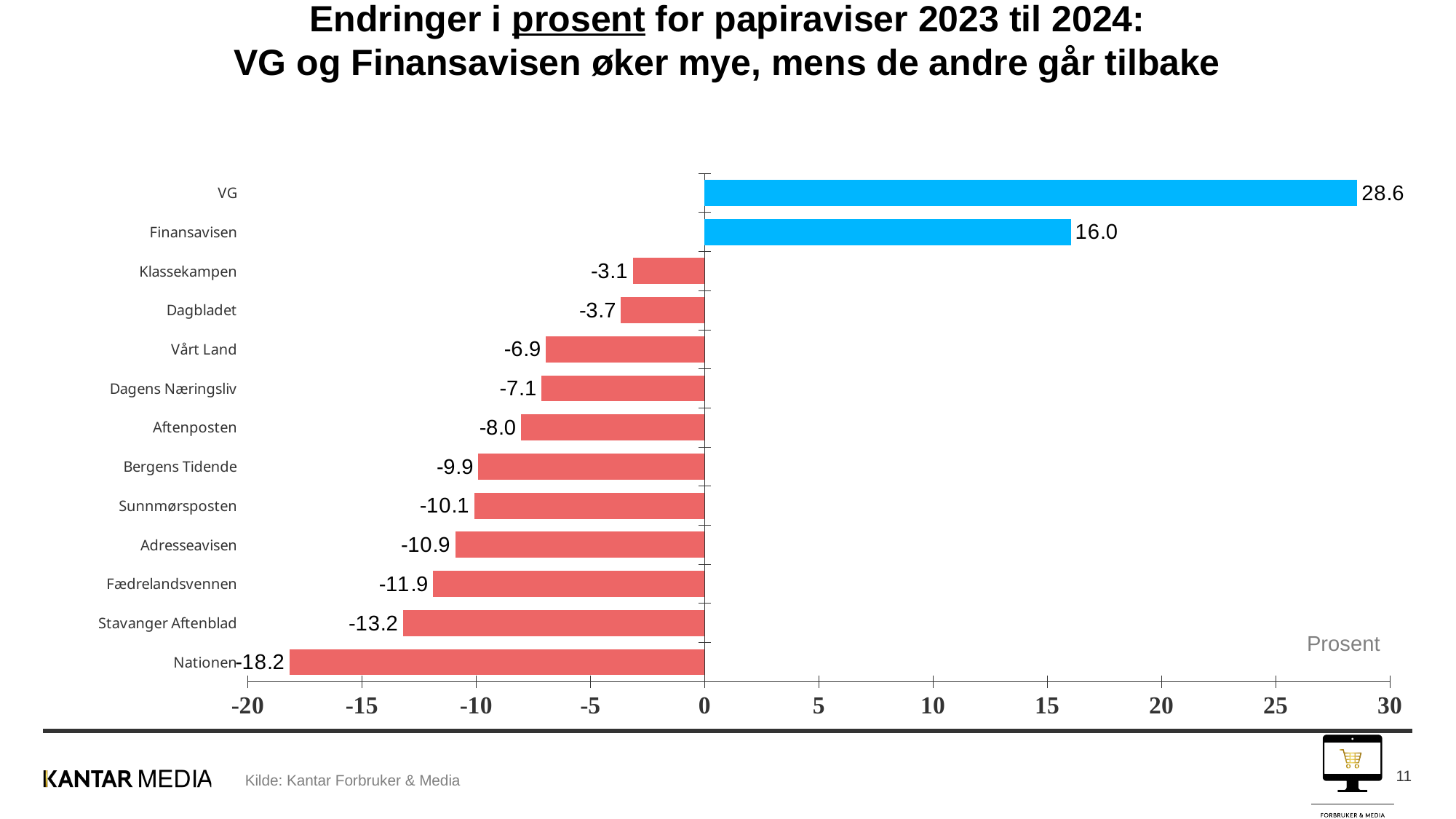
Which newspaper has the lowest value? Nationen What is the value for Aftenposten? -8.0 What is the value for Stavanger Aftenblad? -13.2 How many newspapers have a positive value? 2 What kind of chart is shown on the slide? bar chart What is the difference between the values for VG and Finansavisen? 12.6 What is the value for Nationen? -18.2 Is the value for Finansavisen greater or less than 15? greater Which has a larger value, Klassekampen or Dagbladet? Klassekampen What is the value for VG? 28.6 How many newspapers are shown in the chart? 13 Which newspaper has the highest value? VG